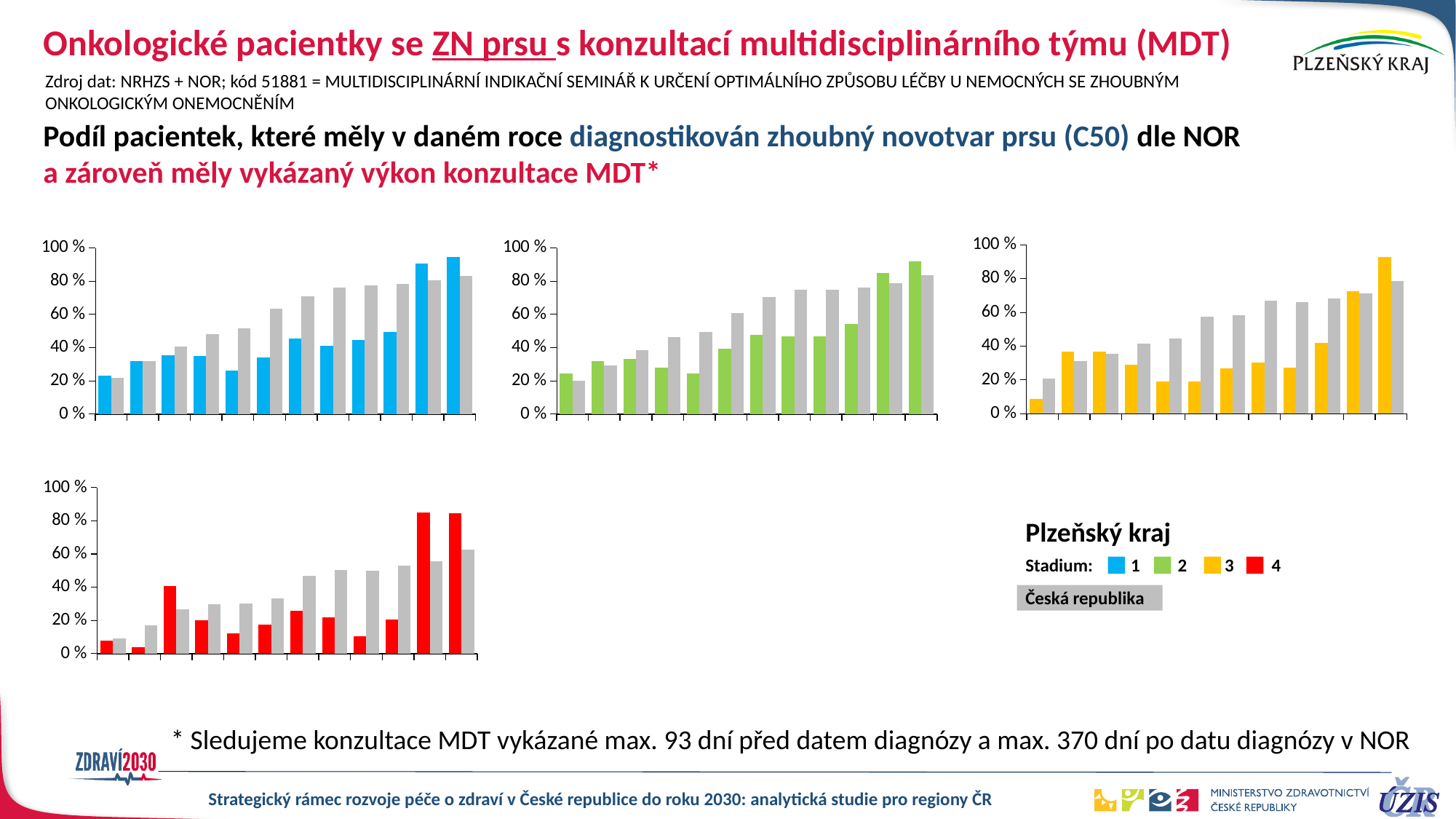
In the bottom-left chart (Stadium 4), is the value of the first (leftmost) red bar greater or less than 20 %? less In the top-middle chart (Stadium 2), is the value of the last (rightmost) green bar greater or less than 80 %? greater In the top-right chart (Stadium 3), is the value of the first (leftmost) yellow bar greater or less than 20 %? less In the top-left chart (Stadium 1), how many blue bars are plotted? 12 What kind of chart is the top-left chart (blue bars)? bar chart In the bottom-left chart (Stadium 4), how many red bars are plotted? 12 In the top-middle chart (Stadium 2), do the grey Česká republika bars generally rise or fall from left to right? rise In the top-right chart (Stadium 3), which is larger for the last (rightmost) pair: the yellow Plzeňský kraj bar or the grey Česká republika bar? the yellow Plzeňský kraj bar Which colour represents Stadium 4 in the legend? red How many charts are shown on the slide? 4 How many series does the legend list in total (stadium entries plus Česká republika)? 5